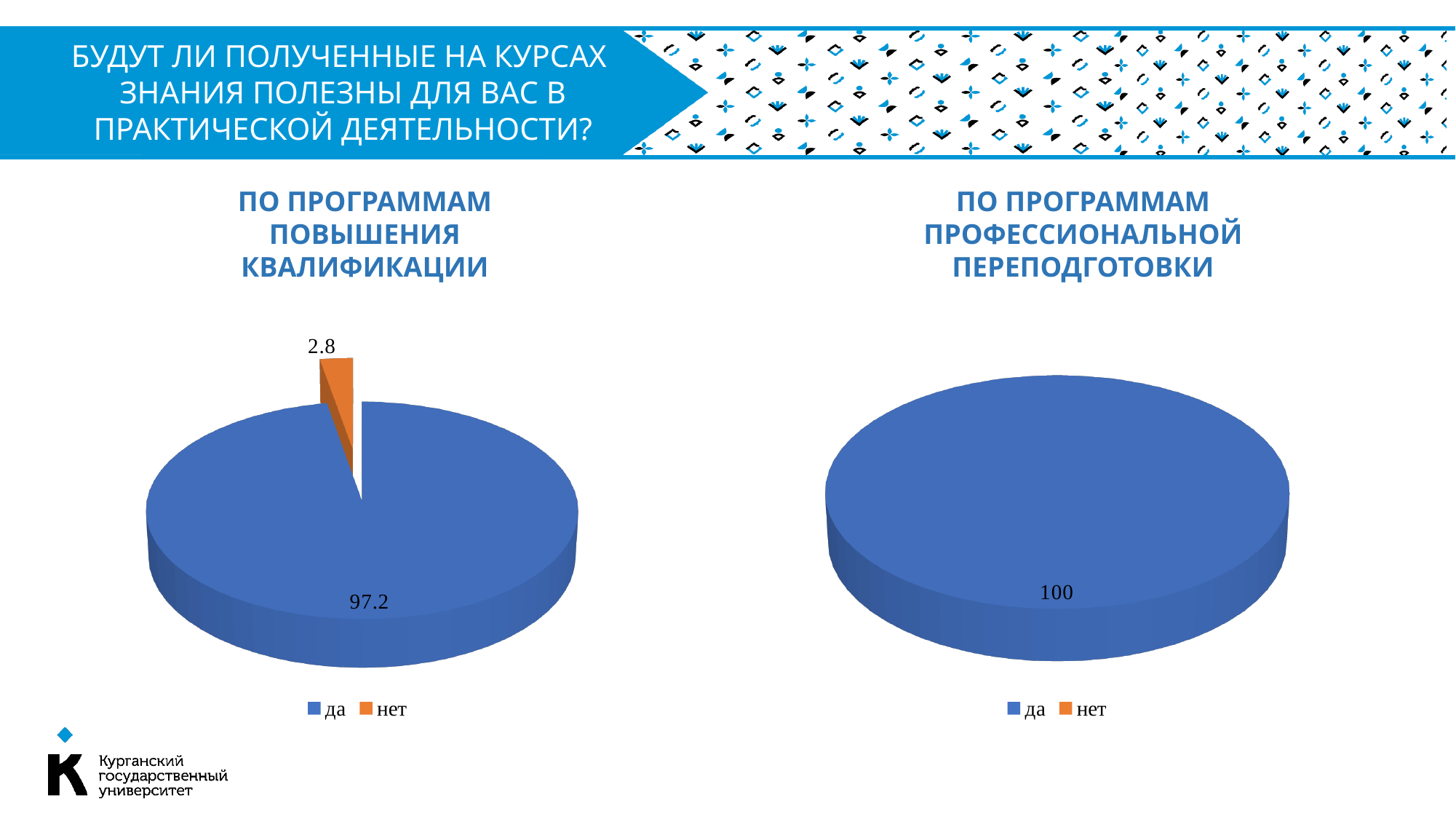
In the left chart (ПО ПРОГРАММАМ ПОВЫШЕНИЯ КВАЛИФИКАЦИИ), which category has the largest slice? да In the left chart (ПО ПРОГРАММАМ ПОВЫШЕНИЯ КВАЛИФИКАЦИИ), what is the value for "нет"? 2.8 In the left chart (ПО ПРОГРАММАМ ПОВЫШЕНИЯ КВАЛИФИКАЦИИ), what is the difference between the values for "да" and "нет"? 94.4 How many entries does the legend of the left chart (ПО ПРОГРАММАМ ПОВЫШЕНИЯ КВАЛИФИКАЦИИ) list? 2 In the right chart (ПО ПРОГРАММАМ ПРОФЕССИОНАЛЬНОЙ ПЕРЕПОДГОТОВКИ), what is the value for "да"? 100 In the left chart (ПО ПРОГРАММАМ ПОВЫШЕНИЯ КВАЛИФИКАЦИИ), which category has the smallest slice? нет In the right chart (ПО ПРОГРАММАМ ПРОФЕССИОНАЛЬНОЙ ПЕРЕПОДГОТОВКИ), what share of the pie does "да" take? 100 What type of chart is the right chart (ПО ПРОГРАММАМ ПРОФЕССИОНАЛЬНОЙ ПЕРЕПОДГОТОВКИ)? Pie chart In the left chart (ПО ПРОГРАММАМ ПОВЫШЕНИЯ КВАЛИФИКАЦИИ), what colour is the "нет" slice? Orange In the left chart (ПО ПРОГРАММАМ ПОВЫШЕНИЯ КВАЛИФИКАЦИИ), which is larger, "да" or "нет"? да In the left chart (ПО ПРОГРАММАМ ПОВЫШЕНИЯ КВАЛИФИКАЦИИ), what is the value for "да"? 97.2 What type of chart is the left chart (ПО ПРОГРАММАМ ПОВЫШЕНИЯ КВАЛИФИКАЦИИ)? Pie chart